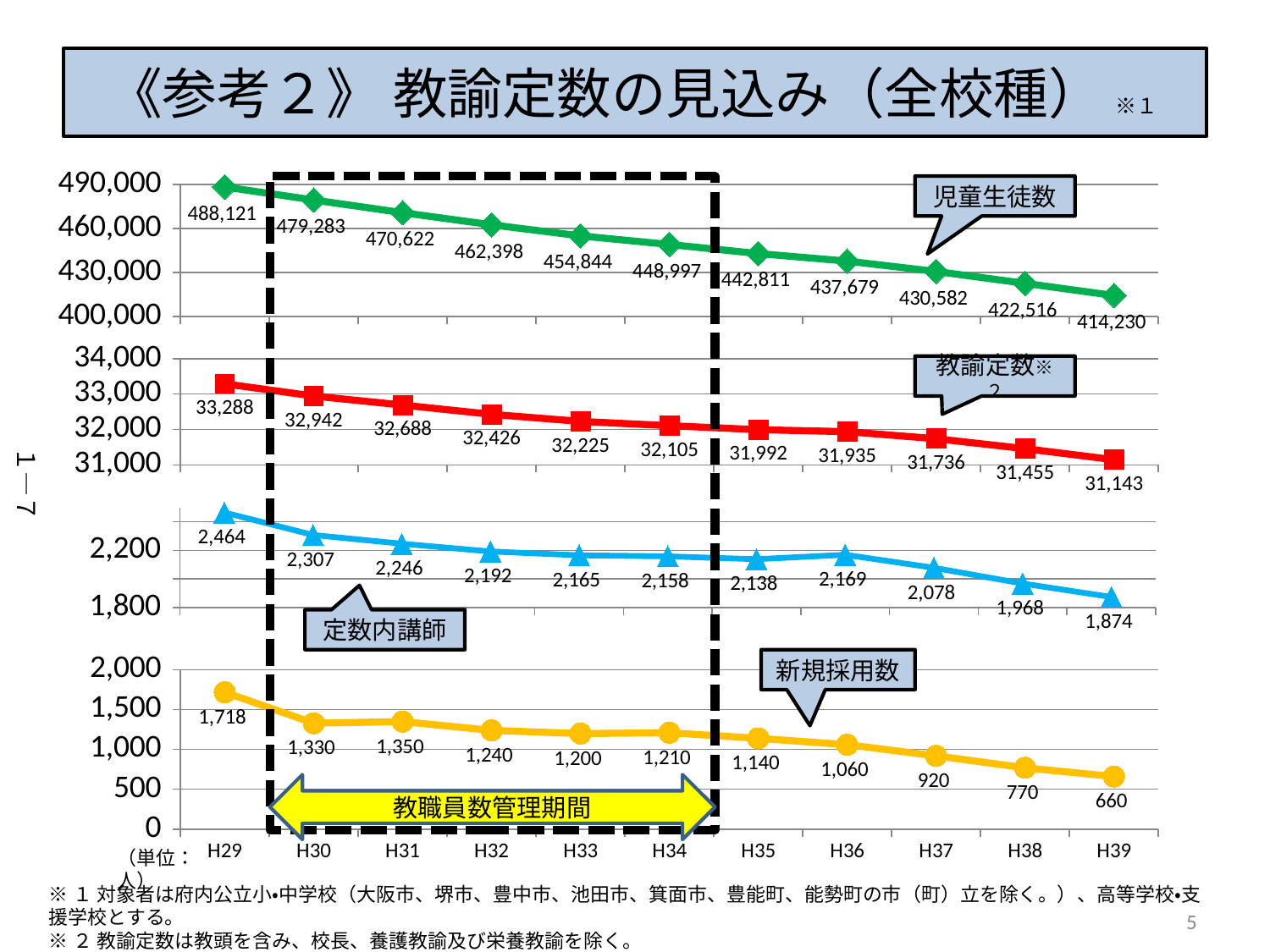
Which is larger, 新規採用数 in H30 or in H31? H31 What is the value of 児童生徒数 in H29? 488,121 How many years are plotted on the x axis? 11 What kind of chart is shown on the slide? Line chart What is the value of 新規採用数 in H39? 660 In which year is 教諭定数 lowest? H39 What colour is the line for 定数内講師? Blue What is the value of 定数内講師 in H36? 2,169 In which year is 新規採用数 highest? H29 Does 児童生徒数 rise or fall from H29 to H39? Fall What is the value of 教諭定数 in H34? 32,105 What is the difference between 児童生徒数 in H29 and in H39? 73,891